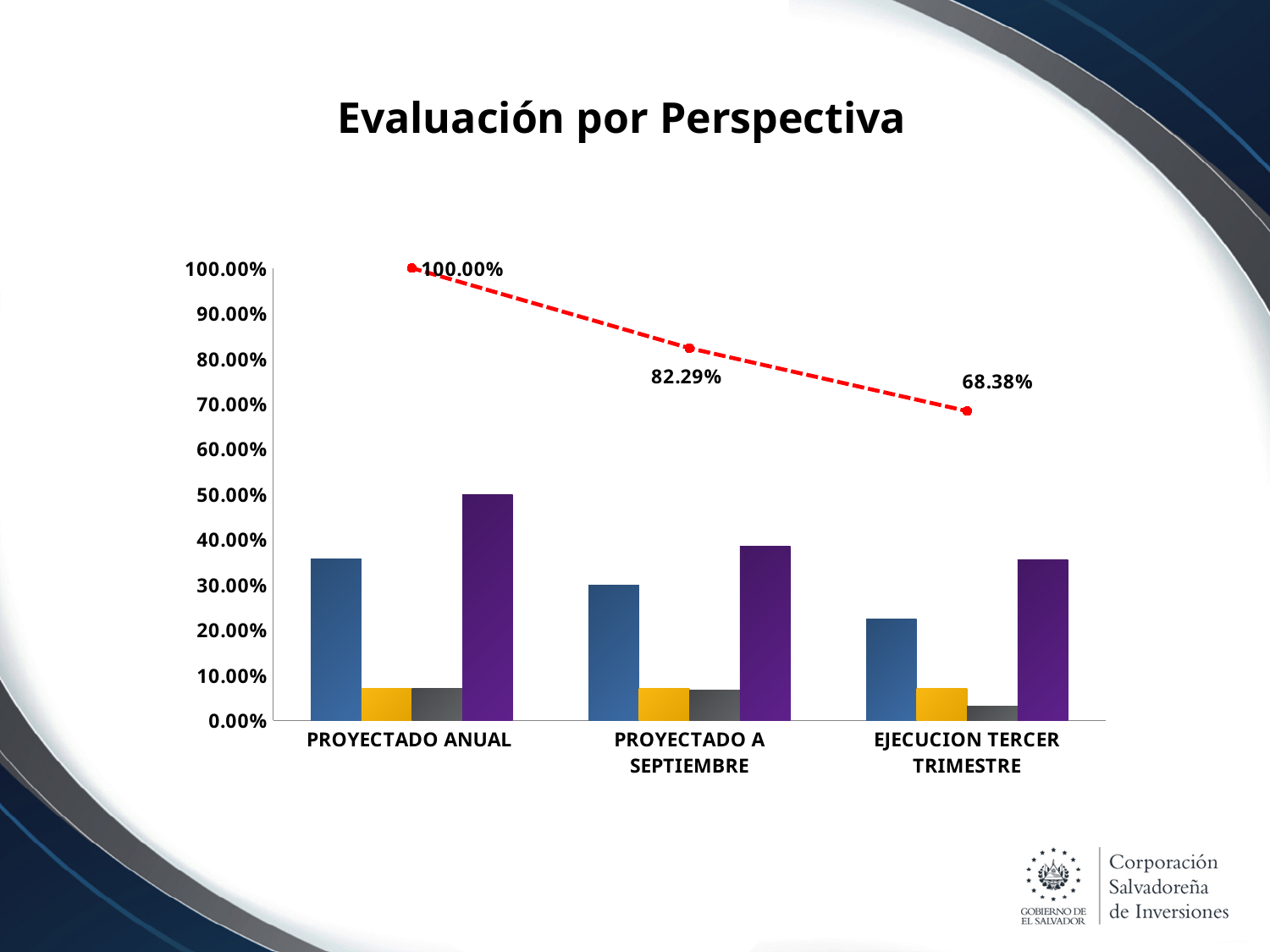
What value does the dashed red line show for EJECUCION TERCER TRIMESTRE? 68.38% How many categories are shown on the x axis? 3 Which has the larger line value, PROYECTADO A SEPTIEMBRE or EJECUCION TERCER TRIMESTRE? PROYECTADO A SEPTIEMBRE For which category is the dashed red line value highest? PROYECTADO ANUAL What is the difference between the line values for PROYECTADO A SEPTIEMBRE and EJECUCION TERCER TRIMESTRE? 13.91% Does the dashed red line rise or fall from left to right across the categories? Fall What value does the dashed red line show for PROYECTADO A SEPTIEMBRE? 82.29% Is the tallest bar for PROYECTADO ANUAL greater or less than 40.00%? greater For which category is the dashed red line value lowest? EJECUCION TERCER TRIMESTRE What is the difference between the line values for PROYECTADO ANUAL and PROYECTADO A SEPTIEMBRE? 17.71% What value does the dashed red line show for PROYECTADO ANUAL? 100.00% What is the title of the chart? Evaluación por Perspectiva